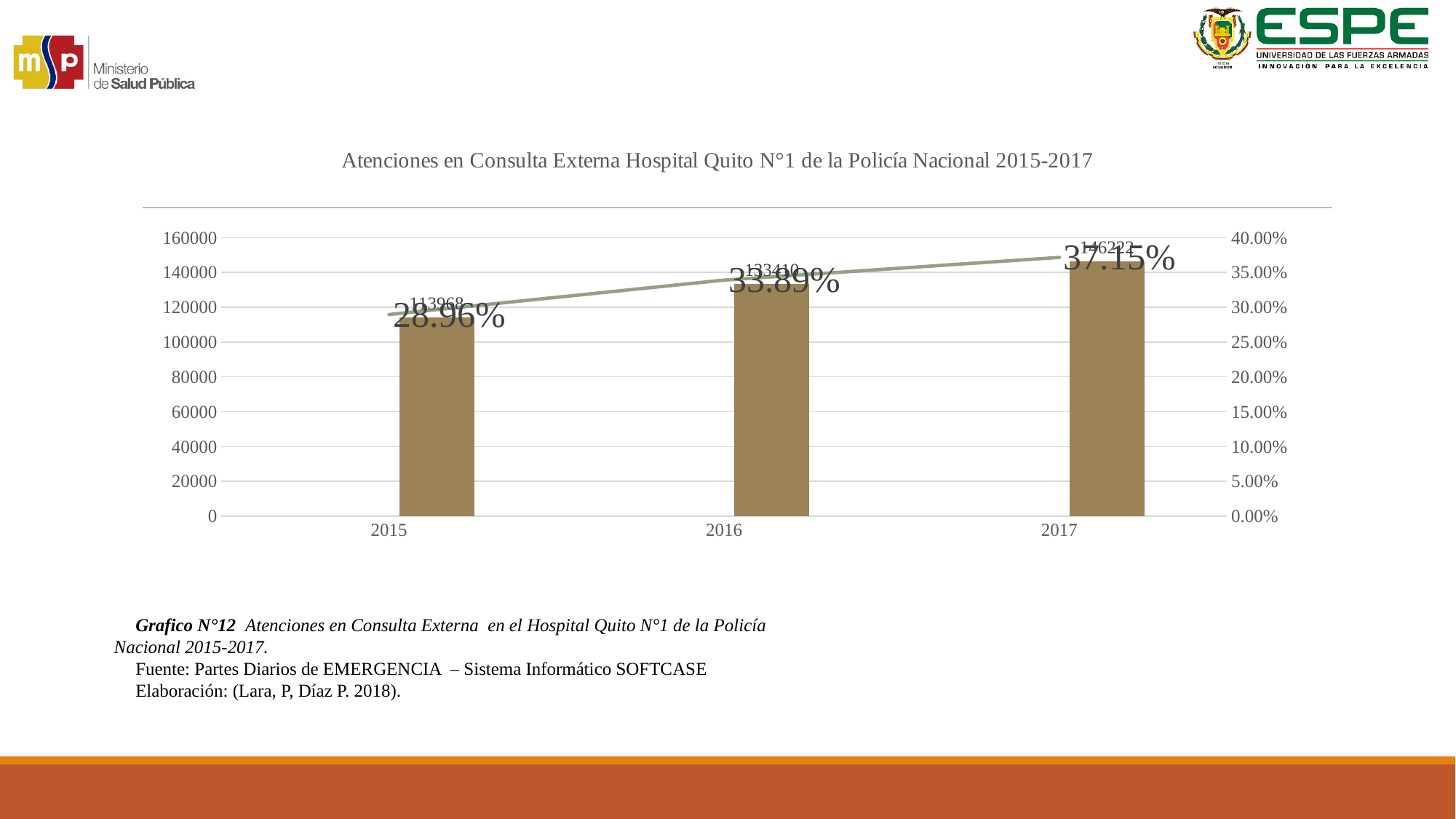
What is the title of the chart? Atenciones en Consulta Externa Hospital Quito N°1 de la Policía Nacional 2015-2017 What percentage is shown on the line for 2017? 37.15% What is the number of outpatient consultations (bar value) for 2017? 146222 What is the number of outpatient consultations (bar value) for 2015? 113968 Is the bar value for 2016 greater or less than 120000? greater Do the bar values rise or fall from 2015 to 2017? rise Which year has the lowest bar value? 2015 Which year has the highest bar value? 2017 How many years are shown on the x axis? 3 What percentage is shown on the line for 2015? 28.96% What is the difference between the bar values for 2017 and 2015? 32254 What percentage is shown on the line for 2016? 33.89%